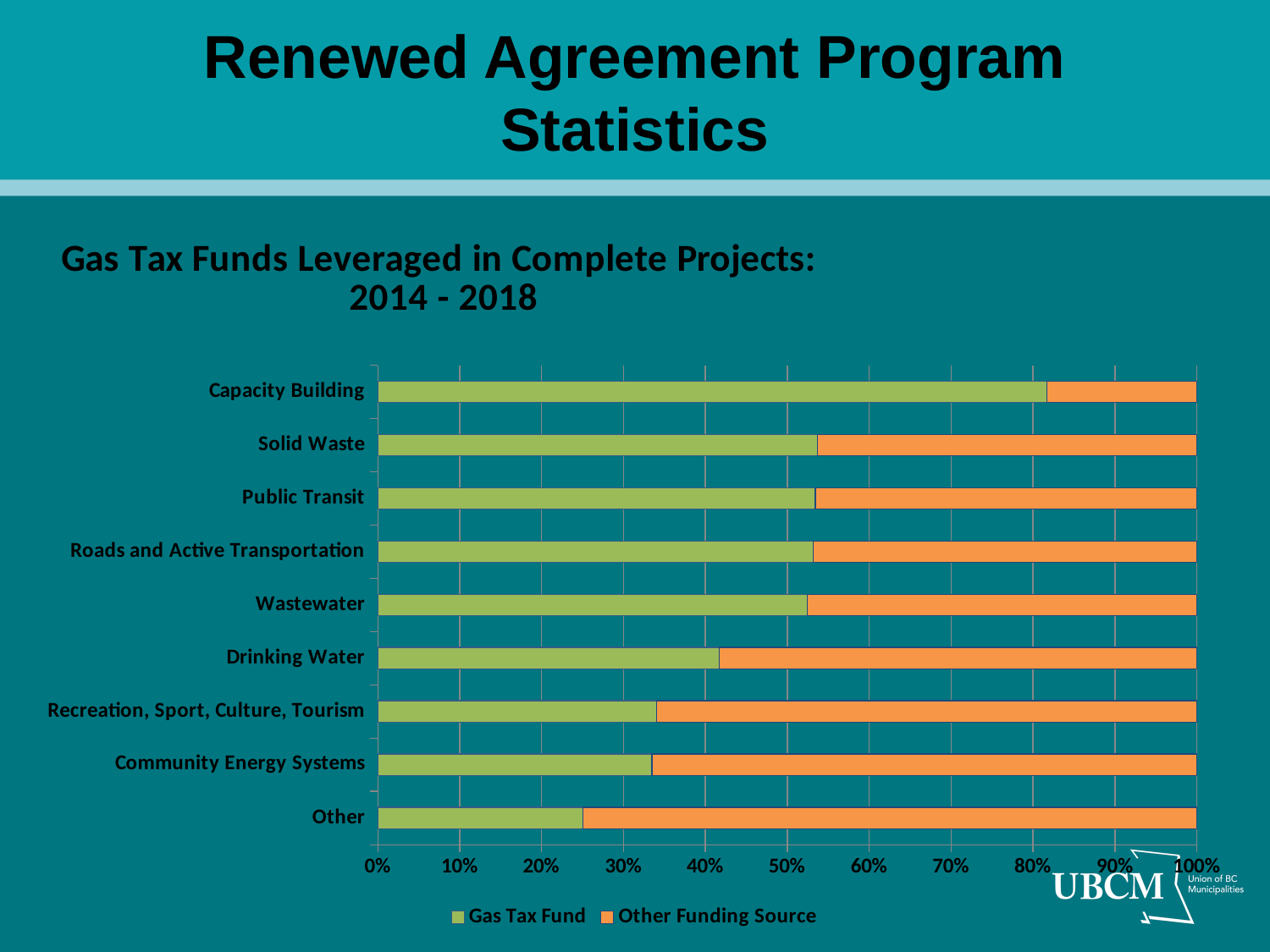
What are the two series named in the legend? Gas Tax Fund and Other Funding Source How many categories are shown on the chart? 9 Is the Gas Tax Fund share for Capacity Building greater or less than 80%? greater Is the Gas Tax Fund share for Drinking Water greater or less than 50%? less Which has a larger Gas Tax Fund share, Solid Waste or Drinking Water? Solid Waste What is the title of the chart? Gas Tax Funds Leveraged in Complete Projects: 2014 - 2018 Is the Gas Tax Fund share for Other greater or less than 30%? less Which category has the largest Gas Tax Fund share? Capacity Building How many series does the legend list? 2 What kind of chart is shown on the slide? bar chart Which category has the smallest Gas Tax Fund share? Other Which has a larger Other Funding Source share, Other or Capacity Building? Other